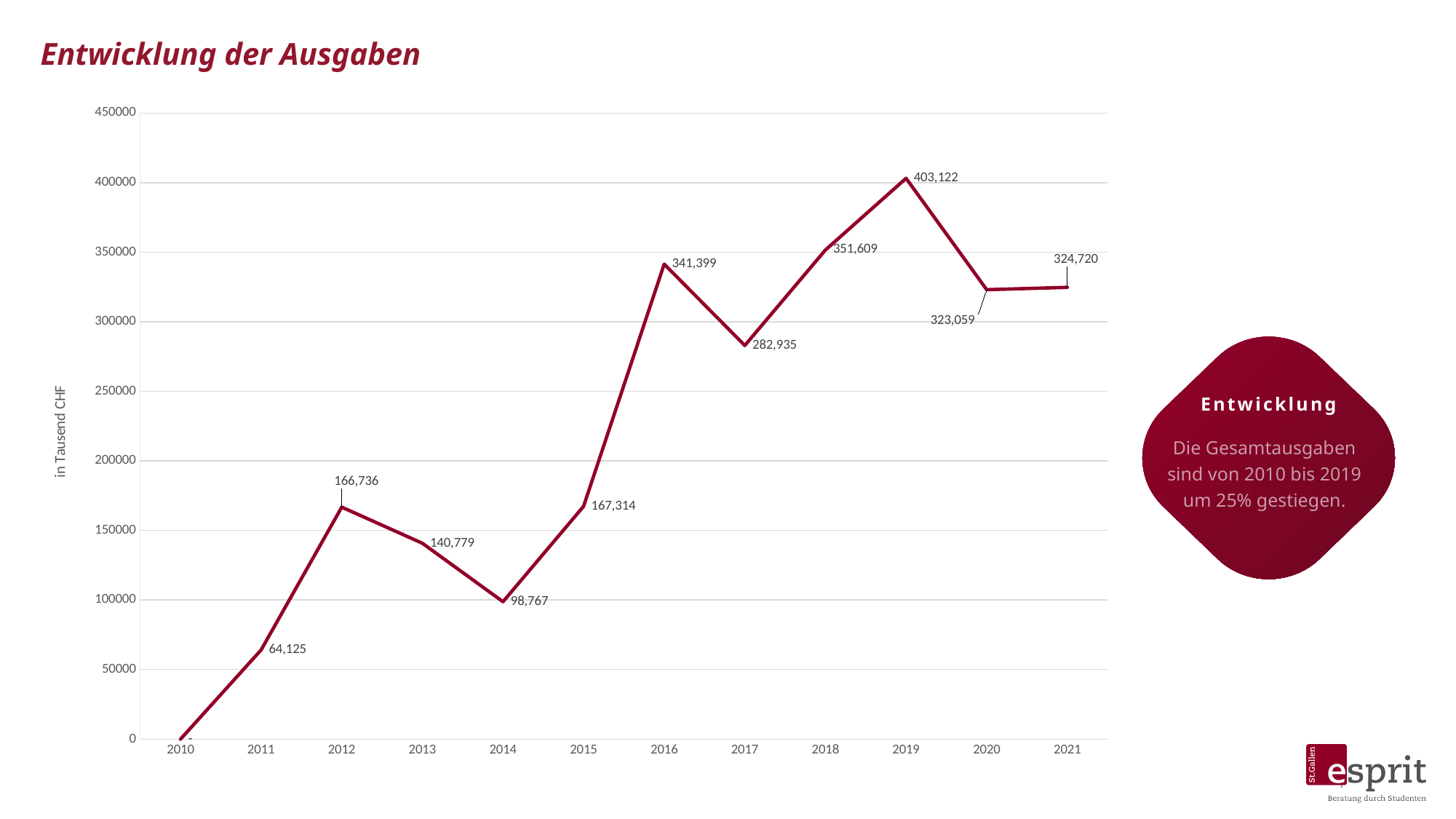
Which is larger, the value for 2017 or the value for 2018? 2018 What is the value for 2020? 323,059 What kind of chart is shown on the slide? line chart How many years are plotted on the x axis? 12 What is the difference between the values for 2019 and 2018? 51,513 What is the difference between the values for 2021 and 2020? 1,661 Do the values rise or fall from 2012 to 2014? fall Which year from 2011 to 2021 has the lowest value? 2011 Is the value for 2016 greater or less than 300000? greater Which year has the highest value? 2019 What is the value for 2019? 403,122 What is the value for 2014? 98,767